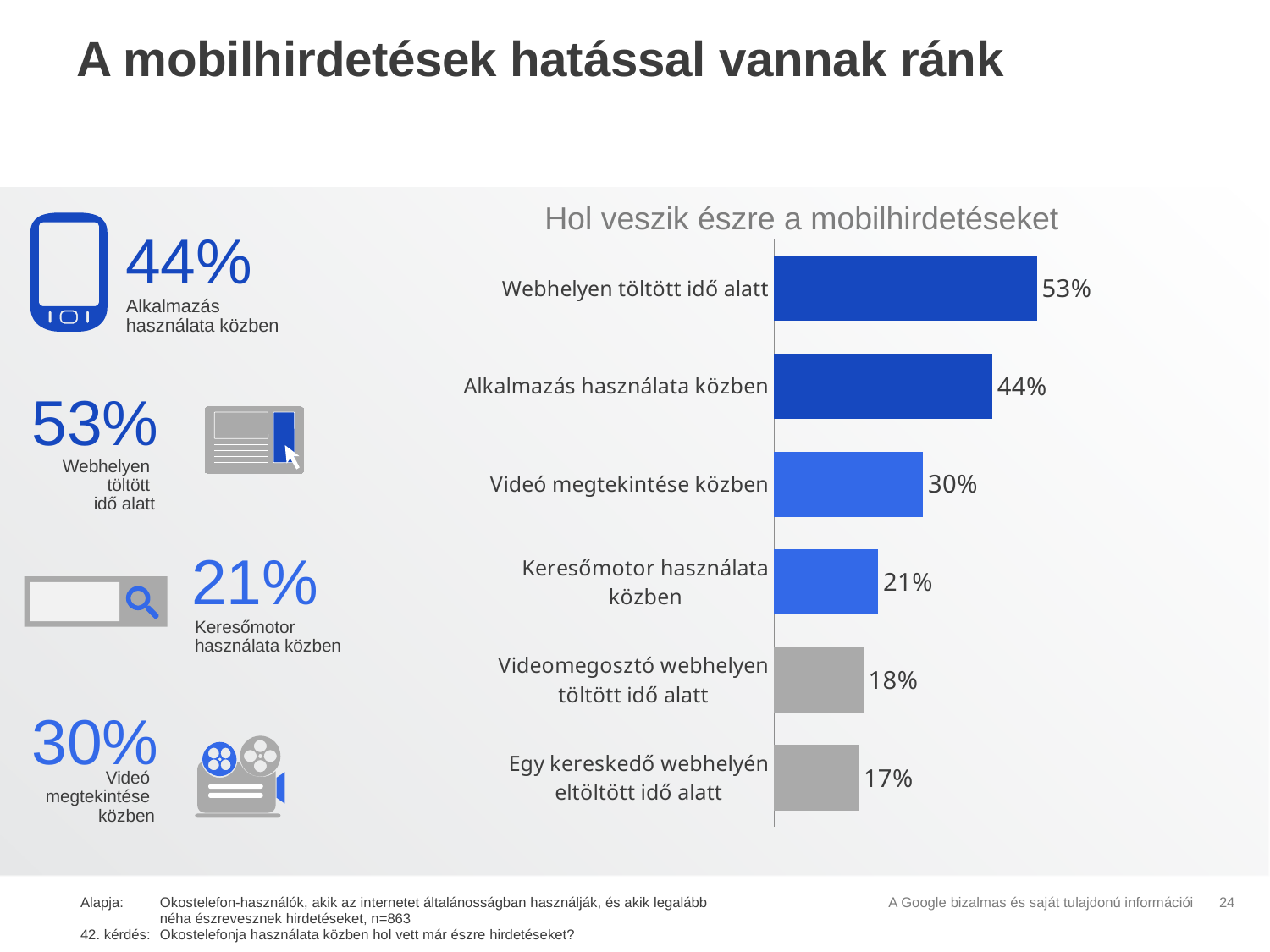
How many categories does the chart show? 6 Do the values rise or fall from the top bar to the bottom bar? Fall What is the value for "Egy kereskedő webhelyén eltöltött idő alatt"? 17% What is the difference between "Videó megtekintése közben" and "Keresőmotor használata közben"? 9% What is the title of the chart? Hol veszik észre a mobilhirdetéseket What kind of chart is shown on the slide? Bar chart Which category has the highest value? Webhelyen töltött idő alatt Which is larger: "Videomegosztó webhelyen töltött idő alatt" or "Keresőmotor használata közben"? Keresőmotor használata közben Which category has the lowest value? Egy kereskedő webhelyén eltöltött idő alatt What is the value for "Webhelyen töltött idő alatt"? 53% What is the value for "Videó megtekintése közben"? 30% What is the difference between "Webhelyen töltött idő alatt" and "Alkalmazás használata közben"? 9%